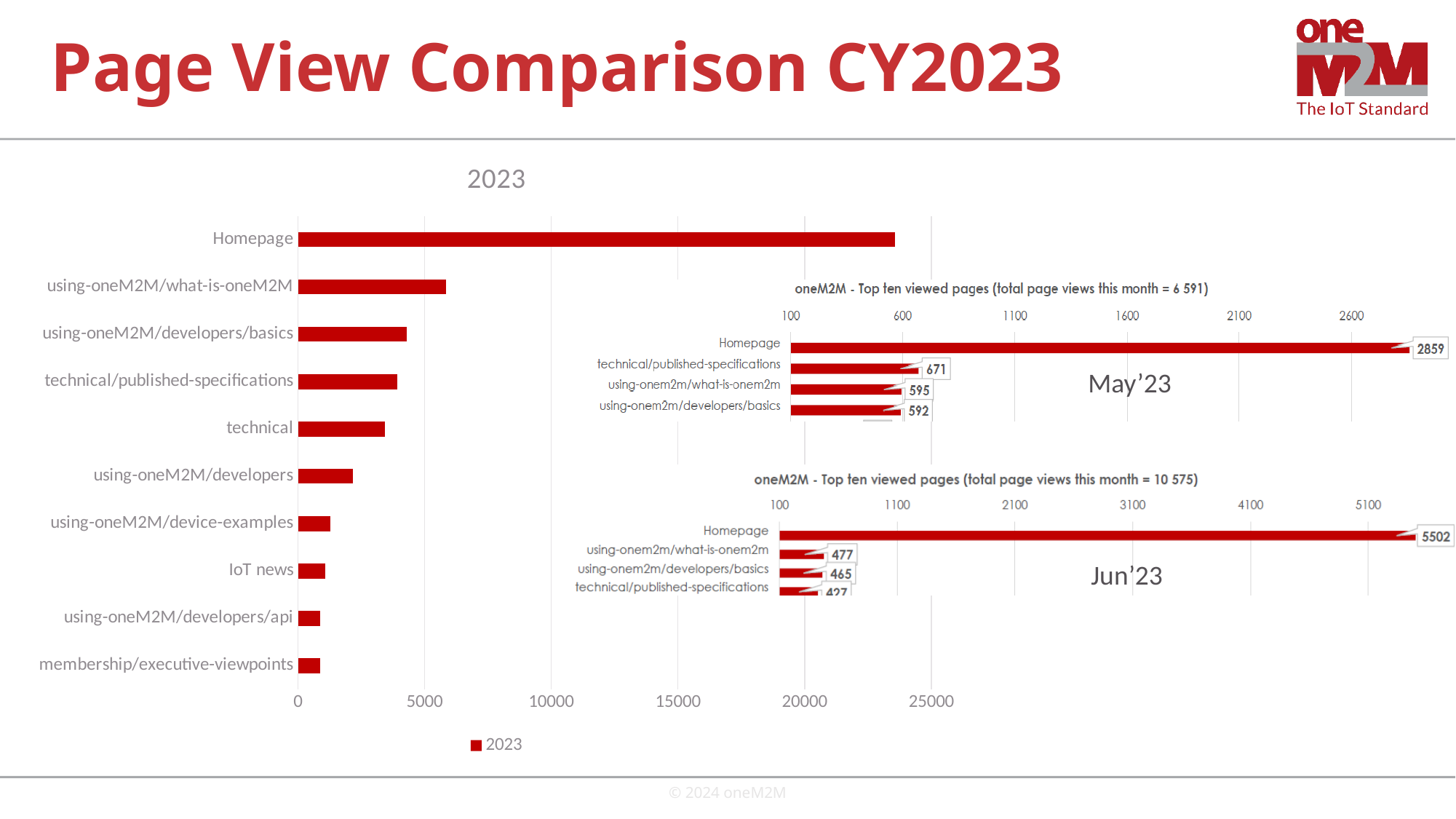
In the May'23 chart, what is the difference between using-onem2m/what-is-onem2m and using-onem2m/developers/basics? 3 In the Jun'23 chart, what is the difference between Homepage and using-onem2m/what-is-onem2m? 5025 In the 2023 chart on the left, which category has the highest page views? Homepage In the 2023 chart on the left, how many series does the legend list? 1 In the May'23 chart, what is the value for technical/published-specifications? 671 In the 2023 chart on the left, which is larger: using-oneM2M/what-is-oneM2M or technical? using-oneM2M/what-is-oneM2M In the 2023 chart on the left, is the value for Homepage greater or less than 20000? greater What kind of chart is the 2023 chart on the left? bar chart In the Jun'23 chart, what is the value for Homepage? 5502 In the 2023 chart on the left, how many categories are shown? 10 In the 2023 chart on the left, is the value for using-oneM2M/developers/basics greater or less than 5000? less In the May'23 chart, what is the value for Homepage? 2859